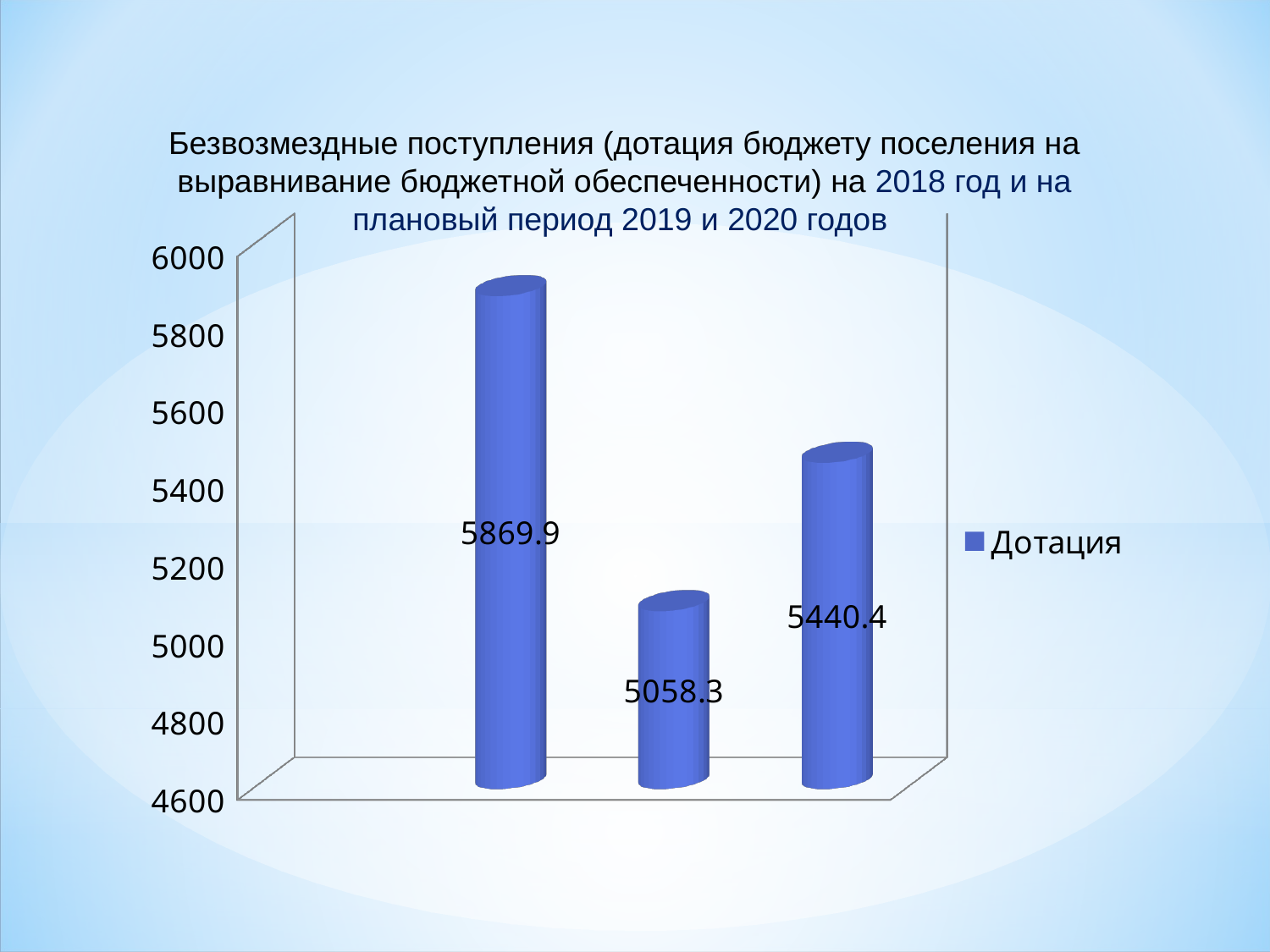
What is the value shown on the leftmost bar? 5869.9 What kind of chart is shown on the slide? Bar chart How many series does the legend list? 1 Which bar has the lowest value? The middle bar (5058.3) Which bar has the highest value? The leftmost bar (5869.9) How many bars are plotted in the chart? 3 What is the value shown on the middle bar? 5058.3 Which is larger, the value of the middle bar or the value of the rightmost bar? The rightmost bar (5440.4) Is the value of the leftmost bar greater or less than 5800? greater What is the value shown on the rightmost bar? 5440.4 What is the difference between the rightmost bar (5440.4) and the middle bar (5058.3)? 382.1 What is the difference between the leftmost bar (5869.9) and the middle bar (5058.3)? 811.6